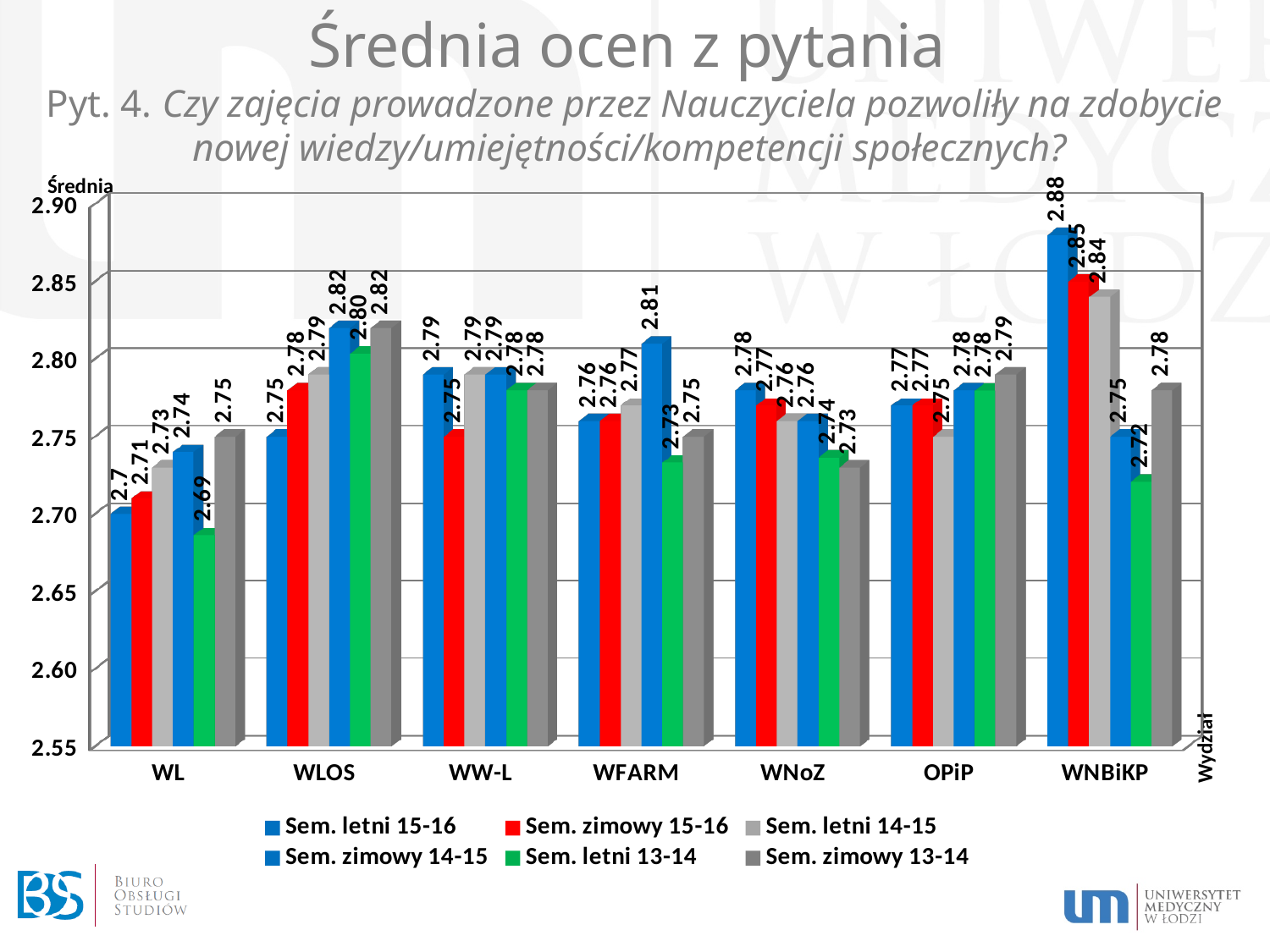
What is the difference between the Sem. zimowy 15-16 values for WNBiKP and WL? 0.14 How many faculties (categories) are shown on the x axis? 7 In the Sem. letni 13-14 series, which is larger: WLOS or WFARM? WLOS What is the label on the vertical axis of the chart? Średnia Which faculty has the highest value in the Sem. zimowy 15-16 series? WNBiKP What is the value for WNoZ in the Sem. letni 14-15 series? 2.76 What is the value for WNBiKP in the Sem. zimowy 15-16 series? 2.85 Is the Sem. zimowy 13-14 value for WLOS greater or less than 2.80? greater Which faculty has the lowest value in the Sem. letni 13-14 series? WL How many series does the legend list? 6 What is the value for WL in the Sem. letni 13-14 series? 2.69 What kind of chart is shown on the slide? bar chart